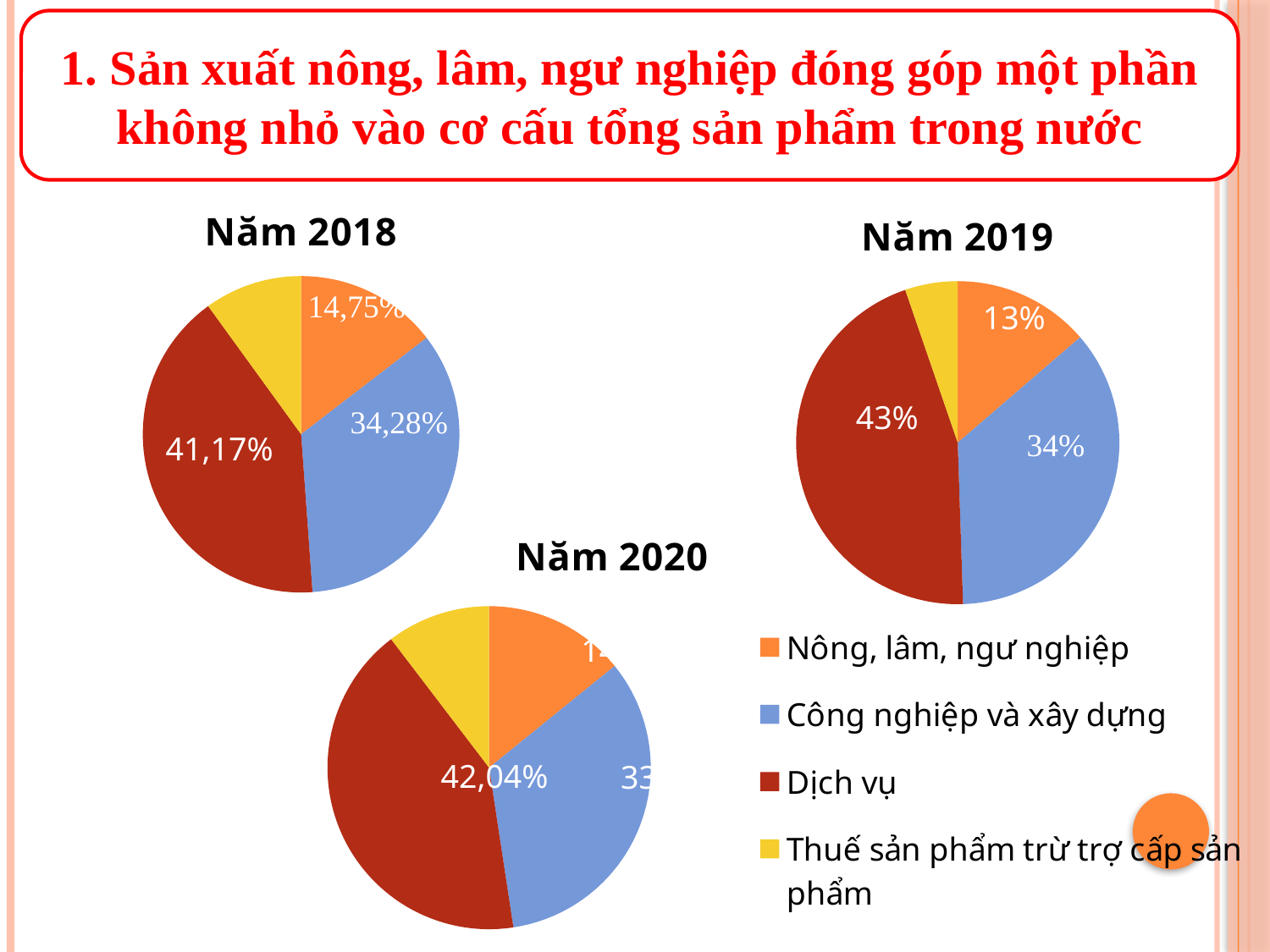
In the Năm 2020 chart, which sector has the smallest slice? Thuế sản phẩm trừ trợ cấp sản phẩm In the Năm 2018 chart, what share does Công nghiệp và xây dựng have? 34,28% What type of chart is used for Năm 2018? Pie chart In the Năm 2019 chart, what share does Nông, lâm, ngư nghiệp have? 13% How many sectors does the legend list? 4 In the Năm 2020 chart, what share does Dịch vụ have? 42,04% In the Năm 2018 chart, what share does Dịch vụ have? 41,17% In the Năm 2019 chart, which is larger: Công nghiệp và xây dựng or Nông, lâm, ngư nghiệp? Công nghiệp và xây dựng In the Năm 2019 chart, which sector has the largest slice? Dịch vụ In the Năm 2018 chart, what is the difference between the Dịch vụ share and the Công nghiệp và xây dựng share? 6,89% In the Năm 2019 chart, what share does Dịch vụ have? 43% In the Năm 2018 chart, what share does Nông, lâm, ngư nghiệp have? 14,75%